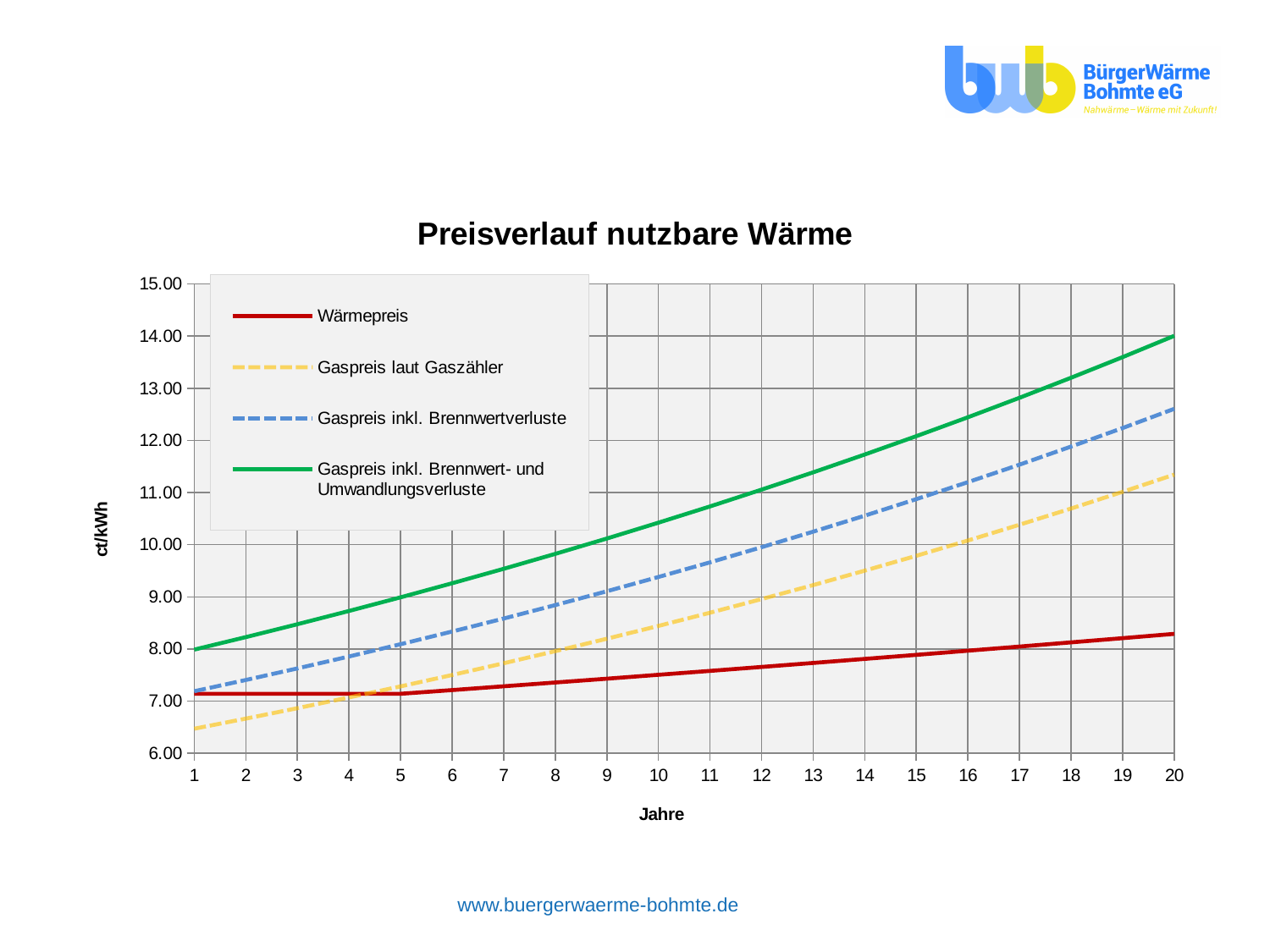
Is the value for Gaspreis inkl. Brennwertverluste at year 20 greater or less than 12.00? greater Is the value for Gaspreis laut Gaszähler at year 1 greater or less than 7.00? less At year 1, which is larger: Wärmepreis or Gaspreis laut Gaszähler? Wärmepreis Which series has the highest value at year 20? Gaspreis inkl. Brennwert- und Umwandlungsverluste Does the Wärmepreis line rise or fall from year 1 to year 20? rise What kind of chart is shown on the slide? line chart How many series does the legend list? 4 How many years are shown on the x axis? 20 What is the title of the chart? Preisverlauf nutzbare Wärme Is the value for Wärmepreis at year 20 greater or less than 9.00? less Which series has the lowest value at year 20? Wärmepreis